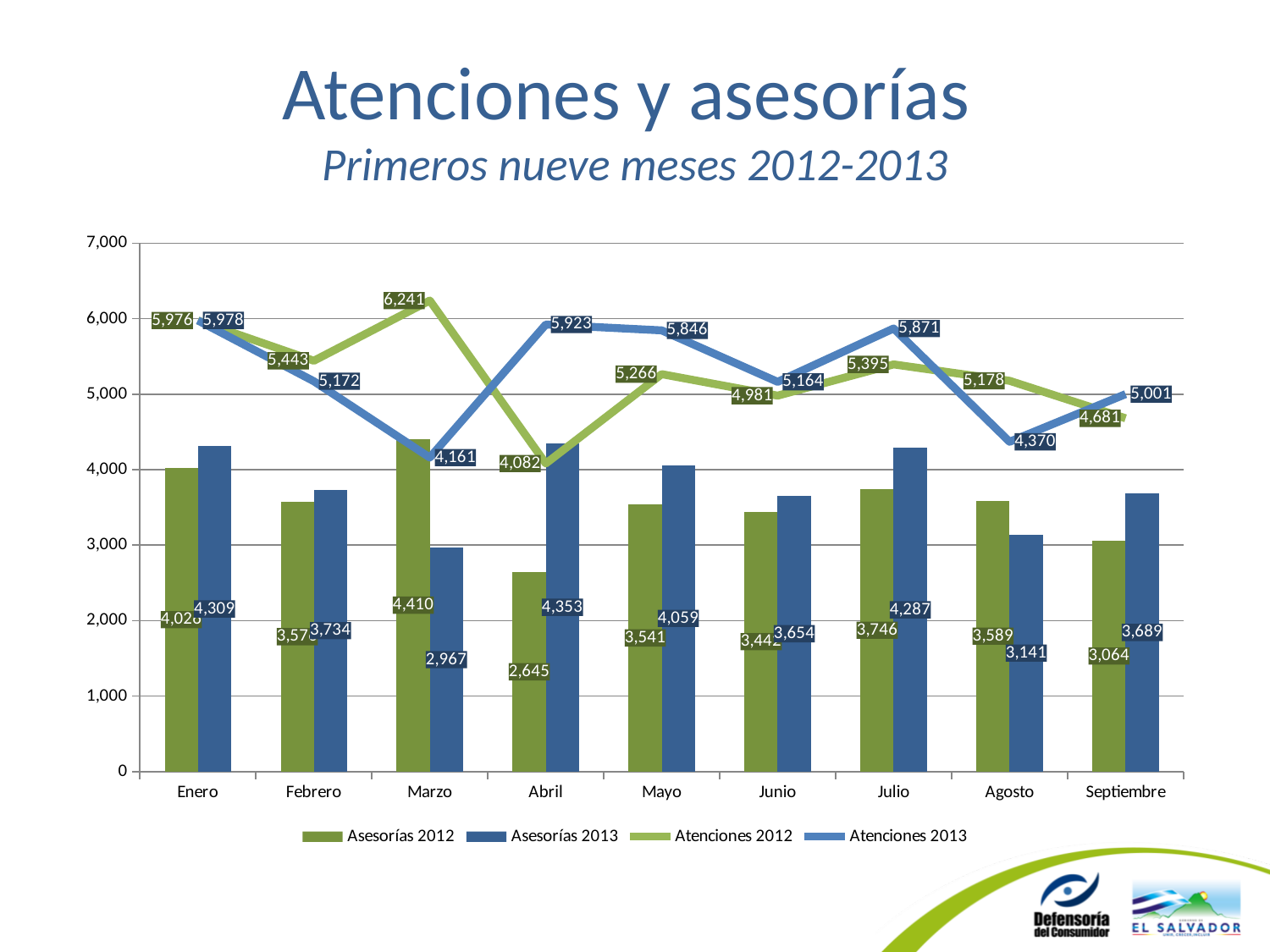
In which month is Atenciones 2012 highest? Marzo In which month is Asesorías 2012 lowest? Abril What is the difference between Asesorías 2013 in Julio and in Agosto? 1,146 What is the difference between Atenciones 2013 in Abril and in Marzo? 1,762 In which month is Asesorías 2013 lowest? Marzo What is the value of Atenciones 2012 in Marzo? 6,241 What kind of chart is shown on the slide? Combined bar and line chart How many months are shown on the x axis? 9 How many series does the legend list? 4 In Mayo, which is larger: Asesorías 2012 or Asesorías 2013? Asesorías 2013 What is the value of Atenciones 2013 in Septiembre? 5,001 What is the value of Asesorías 2013 in Abril? 4,353